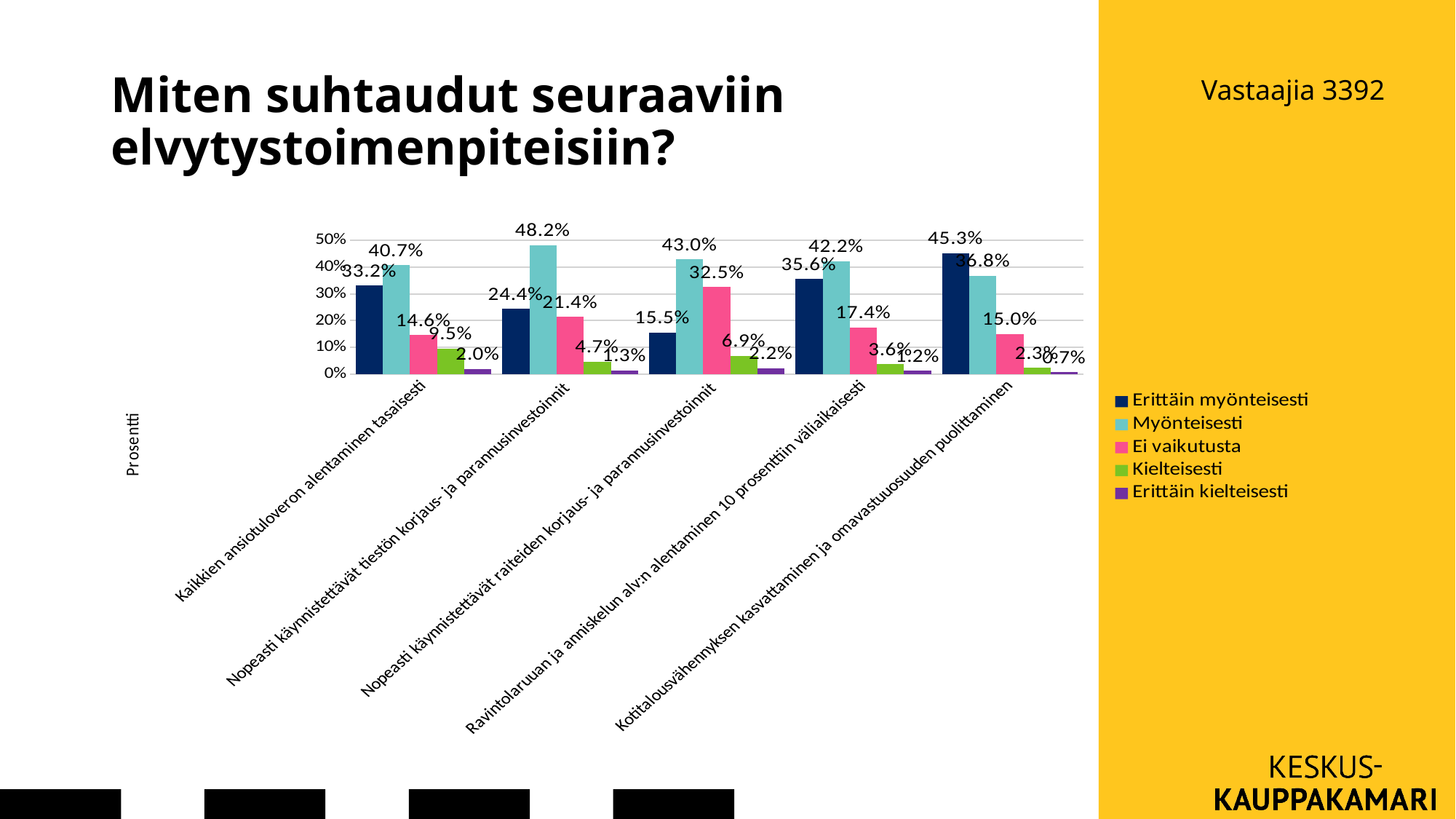
How many categories (measures) are shown on the x axis? 5 What is the 'Erittäin myönteisesti' value for 'Kotitalousvähennyksen kasvattaminen ja omavastuuosuuden puolittaminen'? 45.3% What kind of chart is shown on the slide? bar chart Which category has the highest 'Erittäin myönteisesti' value? Kotitalousvähennyksen kasvattaminen ja omavastuuosuuden puolittaminen How many series does the legend list? 5 For 'Ravintolaruuan ja anniskelun alv:n alentaminen 10 prosenttiin väliaikaisesti', which is larger: 'Erittäin myönteisesti' or 'Myönteisesti'? Myönteisesti What is the 'Ei vaikutusta' value for 'Nopeasti käynnistettävät raiteiden korjaus- ja parannusinvestoinnit'? 32.5% What colour represents the 'Ei vaikutusta' series in the legend? pink Is the 'Kielteisesti' value for 'Kaikkien ansiotuloveron alentaminen tasaisesti' greater or less than 10%? less What is the difference between the 'Myönteisesti' and 'Erittäin myönteisesti' values for 'Kaikkien ansiotuloveron alentaminen tasaisesti'? 7.5% What is the 'Myönteisesti' value for 'Nopeasti käynnistettävät tiestön korjaus- ja parannusinvestoinnit'? 48.2% Which category has the lowest 'Erittäin kielteisesti' value? Kotitalousvähennyksen kasvattaminen ja omavastuuosuuden puolittaminen